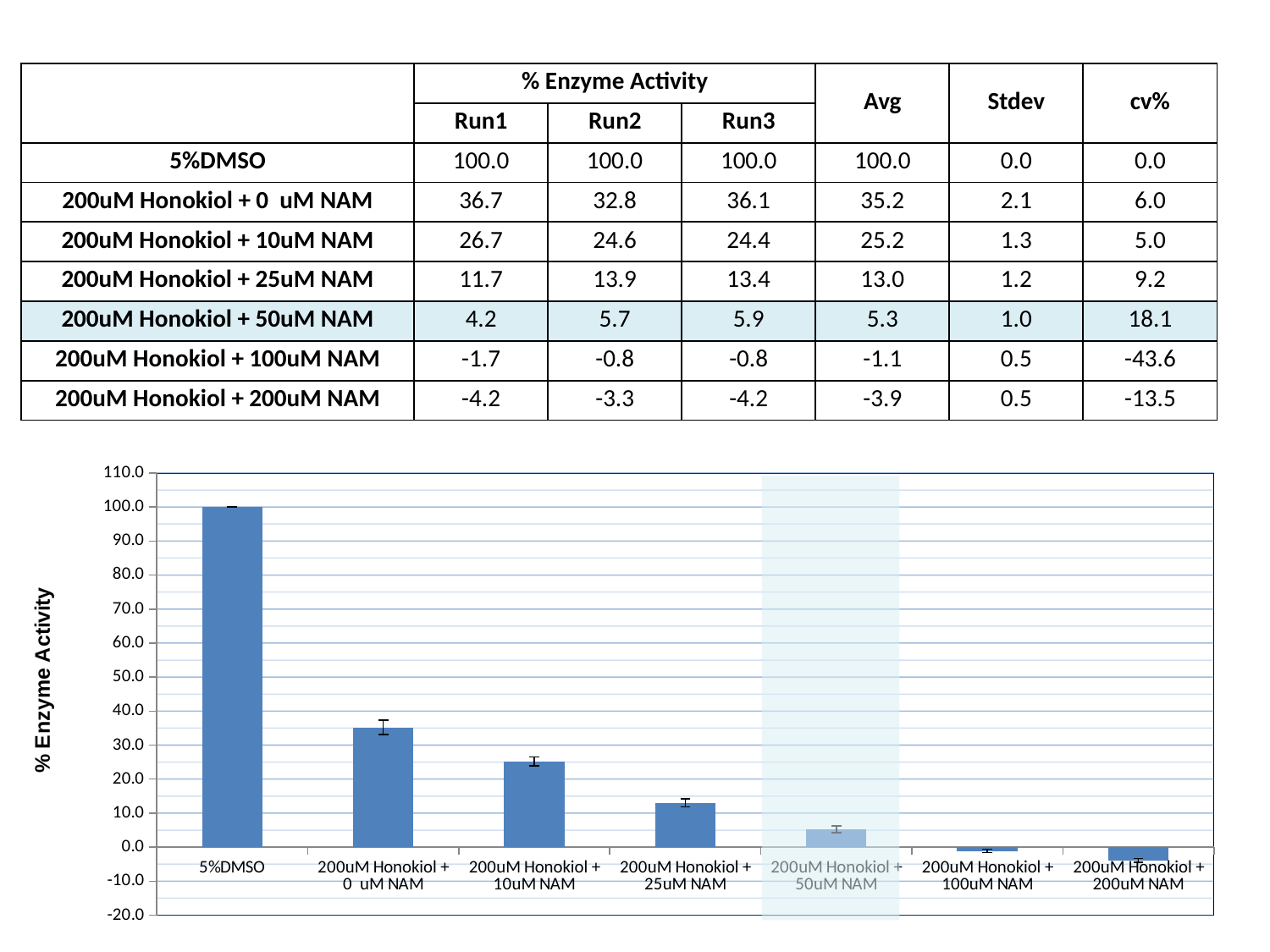
Which category has the highest bar in the chart? 5%DMSO What is the value of the 5%DMSO bar in the chart? 100.0 Is the value for 200uM Honokiol + 25uM NAM greater or less than 10.0? greater Is the value for 200uM Honokiol + 10uM NAM greater or less than 30.0? less Which category has the lowest bar in the chart? 200uM Honokiol + 200uM NAM Is the value for 200uM Honokiol + 50uM NAM greater or less than 10.0? less What kind of chart is shown on the slide? bar chart How many categories are plotted on the x axis of the chart? 7 What is the title of the y axis of the chart? % Enzyme Activity Do the bar values rise or fall moving left to right along the x axis? fall Which is larger, the bar for 200uM Honokiol + 0 uM NAM or the bar for 200uM Honokiol + 10uM NAM? 200uM Honokiol + 0 uM NAM